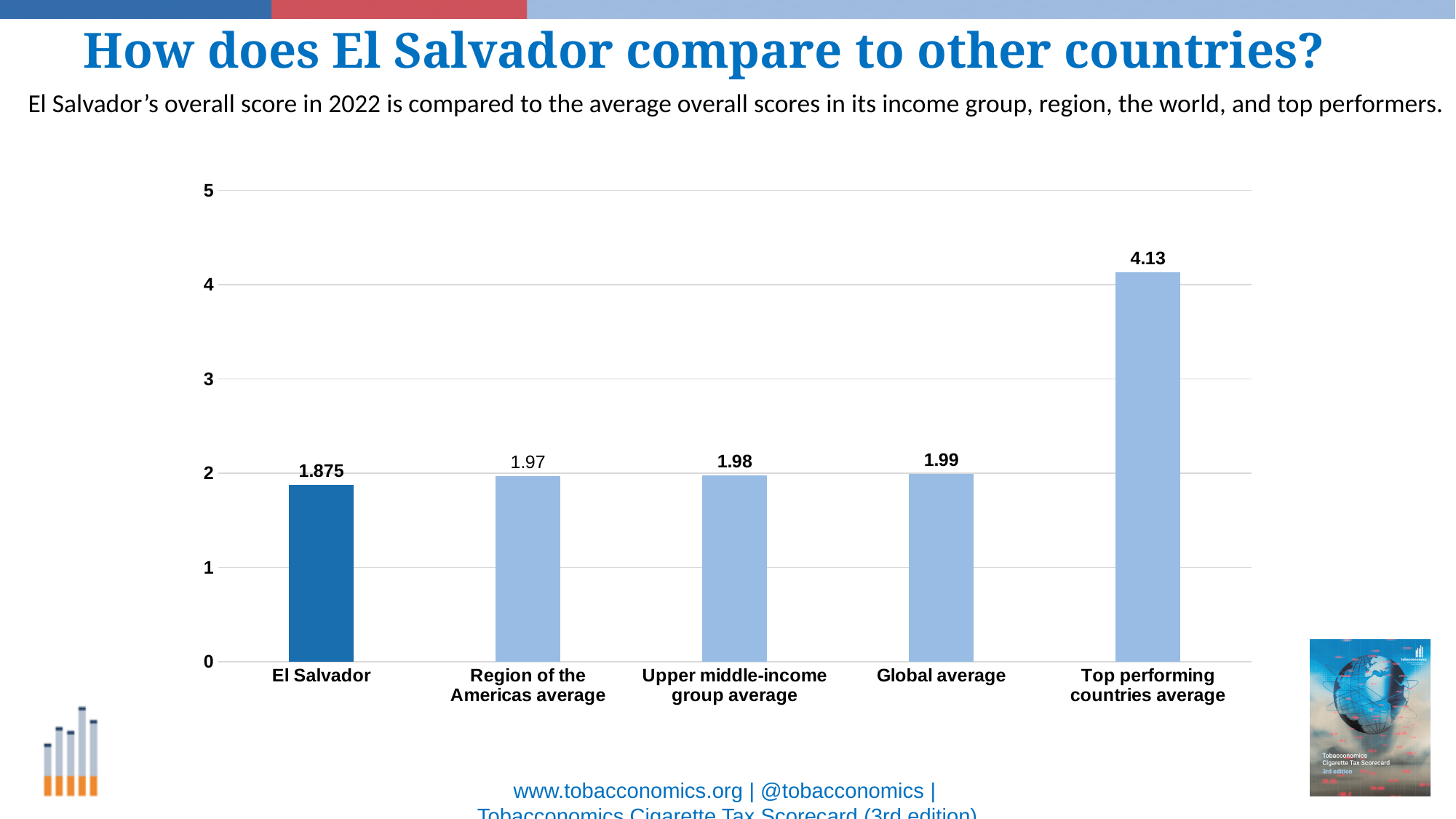
Is the value for El Salvador greater or less than 2? less What is the value for Global average? 1.99 What is the difference between the Top performing countries average and El Salvador? 2.255 What is the value for Top performing countries average? 4.13 What kind of chart is shown on the slide? bar chart How many categories are shown on the chart? 5 What is the difference between the Global average and the Region of the Americas average? 0.02 Which category has the highest value? Top performing countries average What is the value for El Salvador? 1.875 Is the value for Top performing countries average greater or less than 4? greater What is the value for Region of the Americas average? 1.97 What is the value for Upper middle-income group average? 1.98